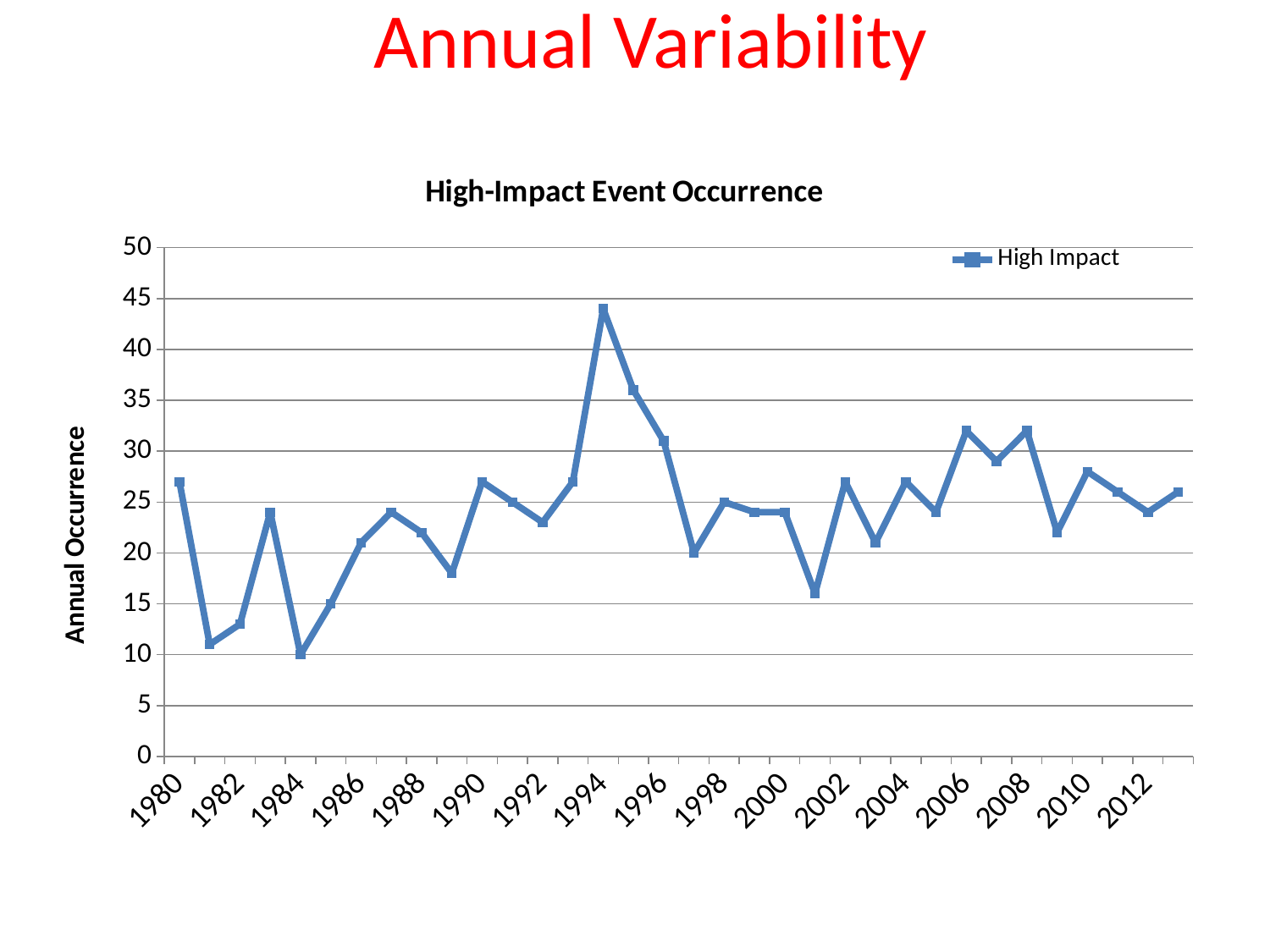
Which year has the larger High Impact value, 1980 or 1981? 1980 What is the name of the series shown in the legend? High Impact Which year has the highest High Impact value? 1994 How many series does the legend list? 1 Is the High Impact value for 1984 greater or less than 15? less Is the High Impact value for 1989 greater or less than 20? less Do the High Impact values rise or fall from 1994 to 1997? fall Is the High Impact value for 2006 greater or less than 30? greater Which year has the larger High Impact value, 1994 or 1996? 1994 What is the title of the vertical axis? Annual Occurrence What kind of chart is shown on the slide? line chart